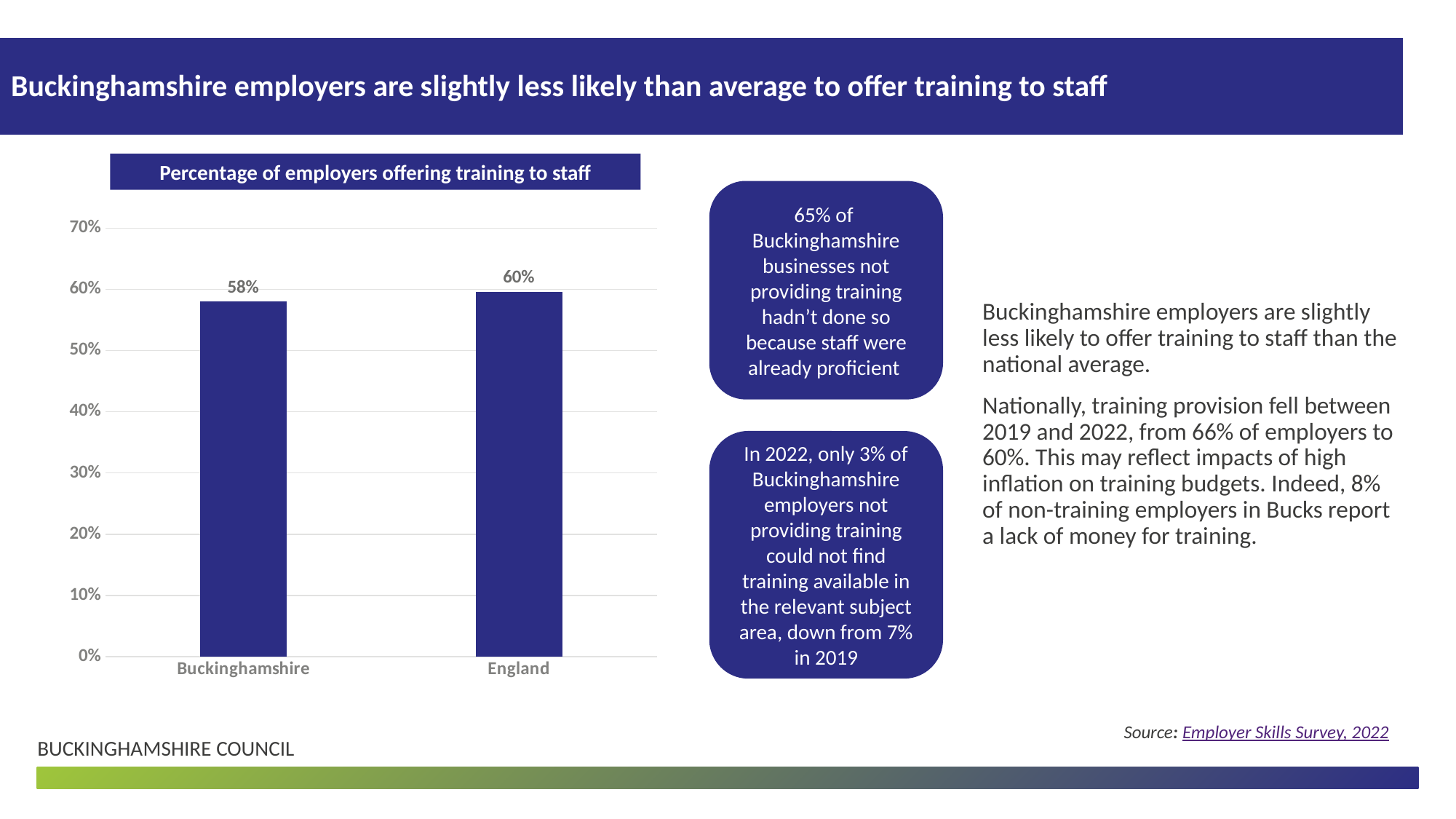
Is the value for England greater or less than 70%? less What is the title of the chart? Percentage of employers offering training to staff What is the highest value shown on the chart's y axis? 70% Which category has the higher percentage of employers offering training to staff? England Is the value for Buckinghamshire greater or less than 50%? greater How many categories are shown on the x axis of the chart? 2 What percentage of employers in England offer training to staff? 60% What percentage of employers in Buckinghamshire offer training to staff? 58% Is the value for Buckinghamshire larger or smaller than the value for England? smaller What type of chart is shown on the slide? bar chart Which category has the lower percentage of employers offering training to staff? Buckinghamshire What is the difference in percentage points between England and Buckinghamshire in the chart? 2 percentage points